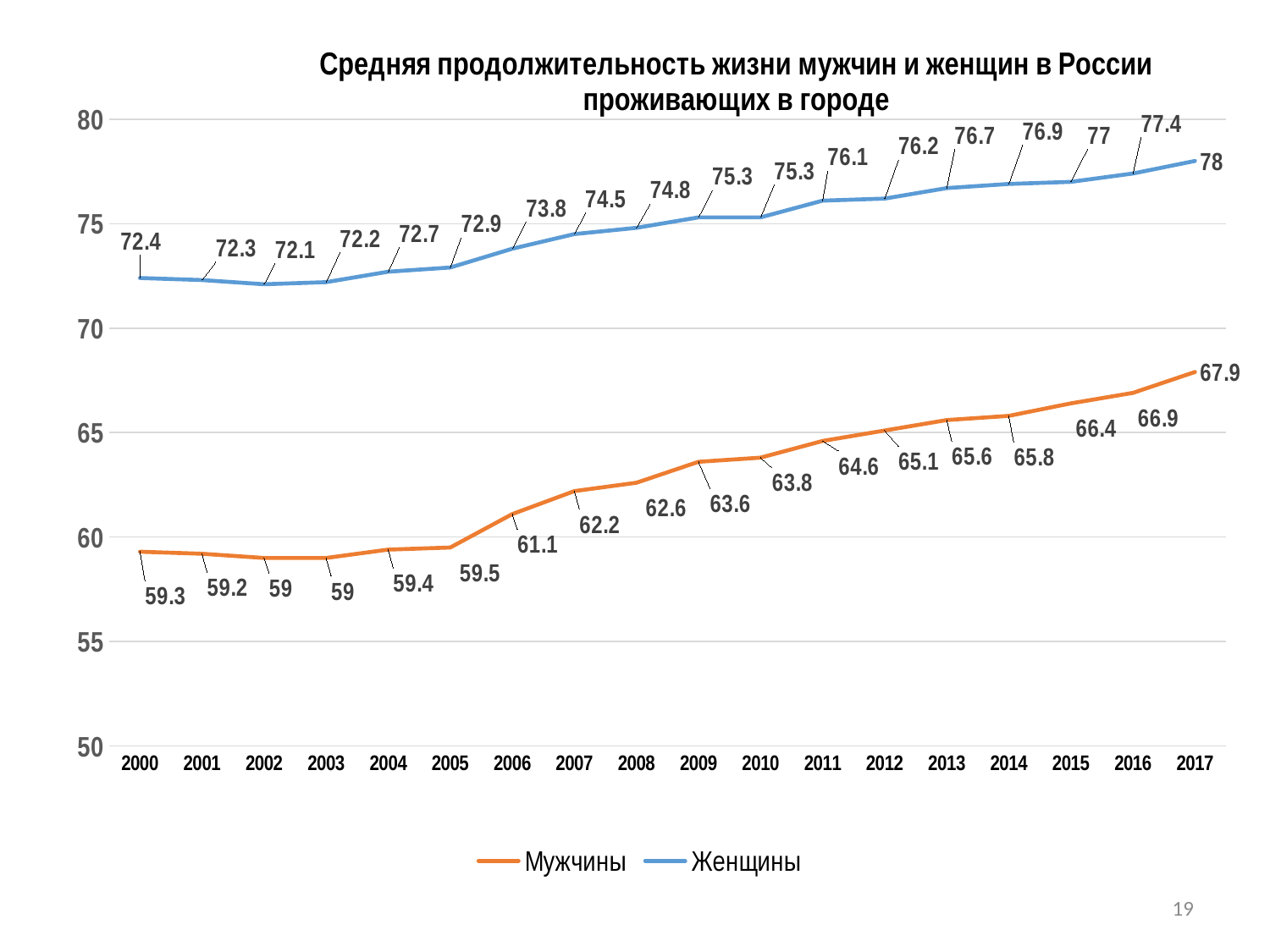
Do the values for Мужчины generally rise or fall from 2005 to 2017? rise What is the value for Женщины in 2000? 72.4 What is the value for Женщины in 2013? 76.7 What is the value for Мужчины in 2017? 67.9 Which is larger: the Мужчины value in 2010 or the Мужчины value in 2005? 2010 In which year is the value for Женщины lowest? 2002 In which year is the value for Мужчины highest? 2017 What is the value for Мужчины in 2006? 61.1 How many series does the legend list? 2 What kind of chart is this? line chart How many years are shown on the x axis? 18 What is the difference between the Женщины and Мужчины values in 2017? 10.1